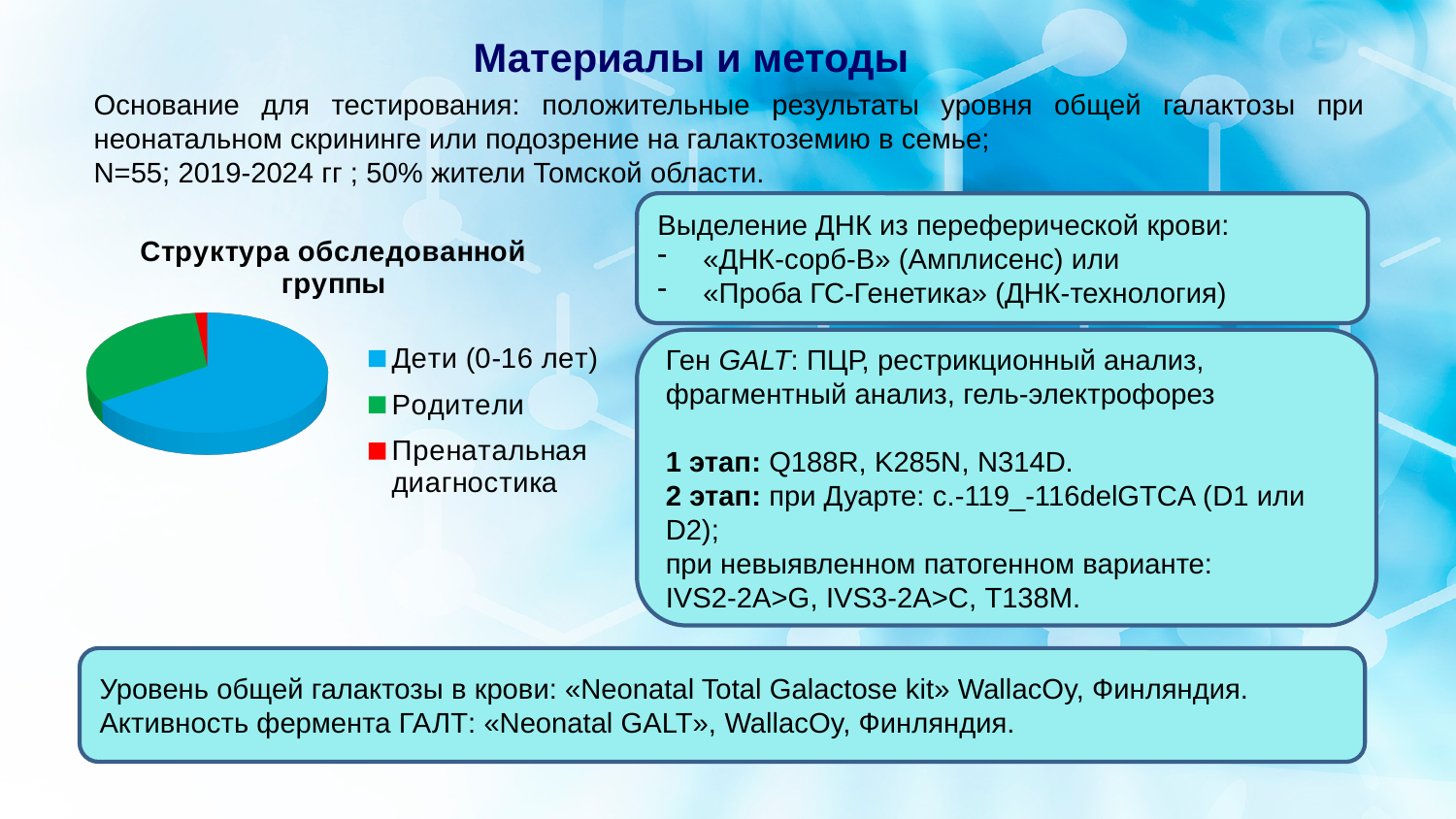
What is the title of the pie chart? Структура обследованной группы Which slice is larger: Дети (0-16 лет) or Родители? Дети (0-16 лет) What kind of chart is shown on the slide? Pie chart Which slice is larger: Родители or Пренатальная диагностика? Родители What colour is the slice for Родители in the pie chart? Green How many categories does the pie chart legend list? 3 Which category has the smallest slice of the pie chart? Пренатальная диагностика Which category has the largest slice of the pie chart? Дети (0-16 лет) Which category is shown in blue in the pie chart? Дети (0-16 лет) Which category is shown in red in the pie chart? Пренатальная диагностика